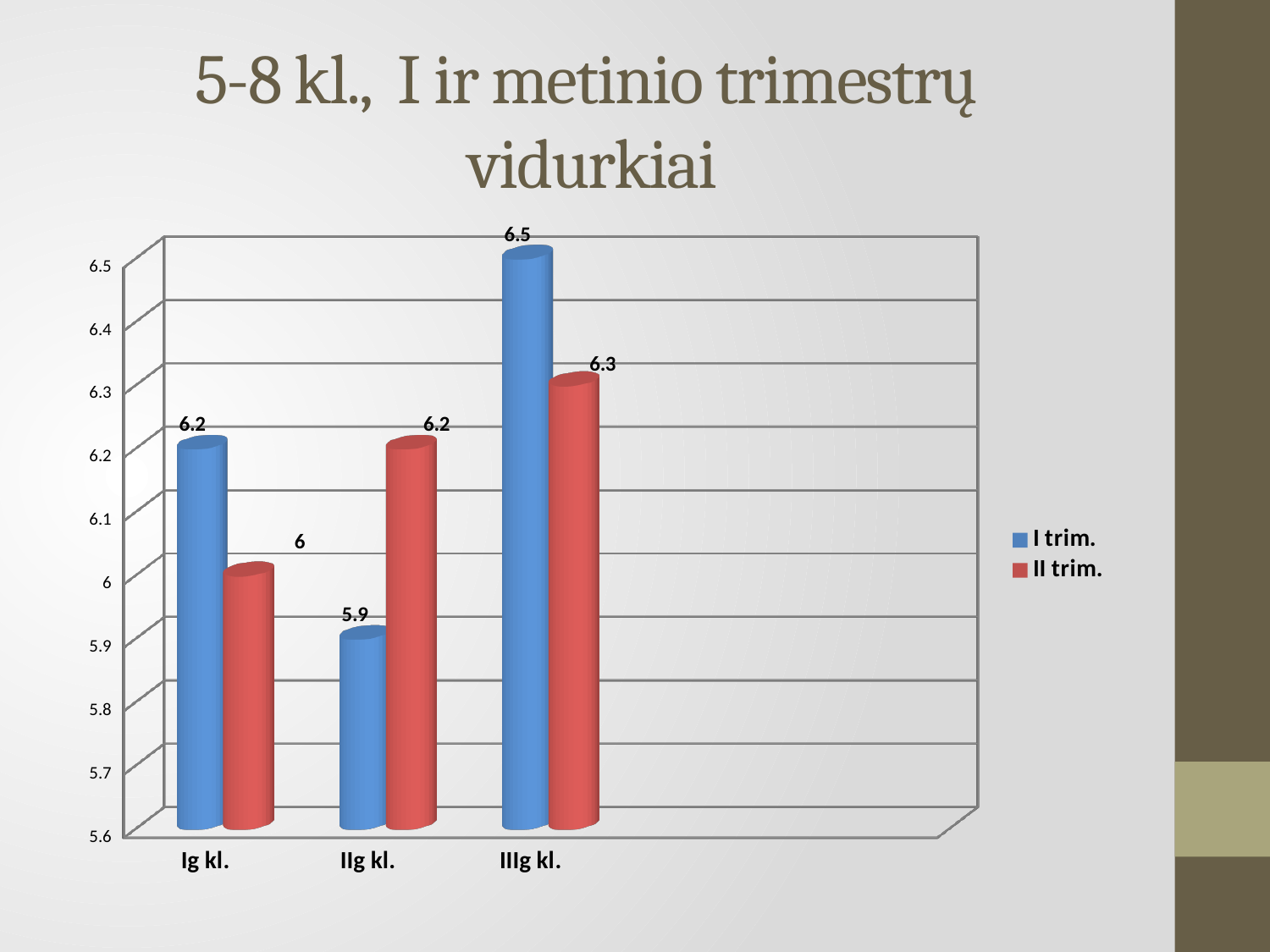
What is the value for II trim. in Ig kl.? 6 How many series does the legend list? 2 What is the value for II trim. in IIIg kl.? 6.3 Which colour represents the II trim. series? Red What is the value for I trim. in IIg kl.? 5.9 How many categories are shown on the x axis? 3 Which category has the lowest value for II trim.? Ig kl. What is the difference between the I trim. and II trim. values in IIIg kl.? 0.2 Which category has the highest value for I trim.? IIIg kl. In IIg kl., which is larger, the I trim. value or the II trim. value? II trim. What kind of chart is shown on the slide? Bar chart What is the value for I trim. in Ig kl.? 6.2